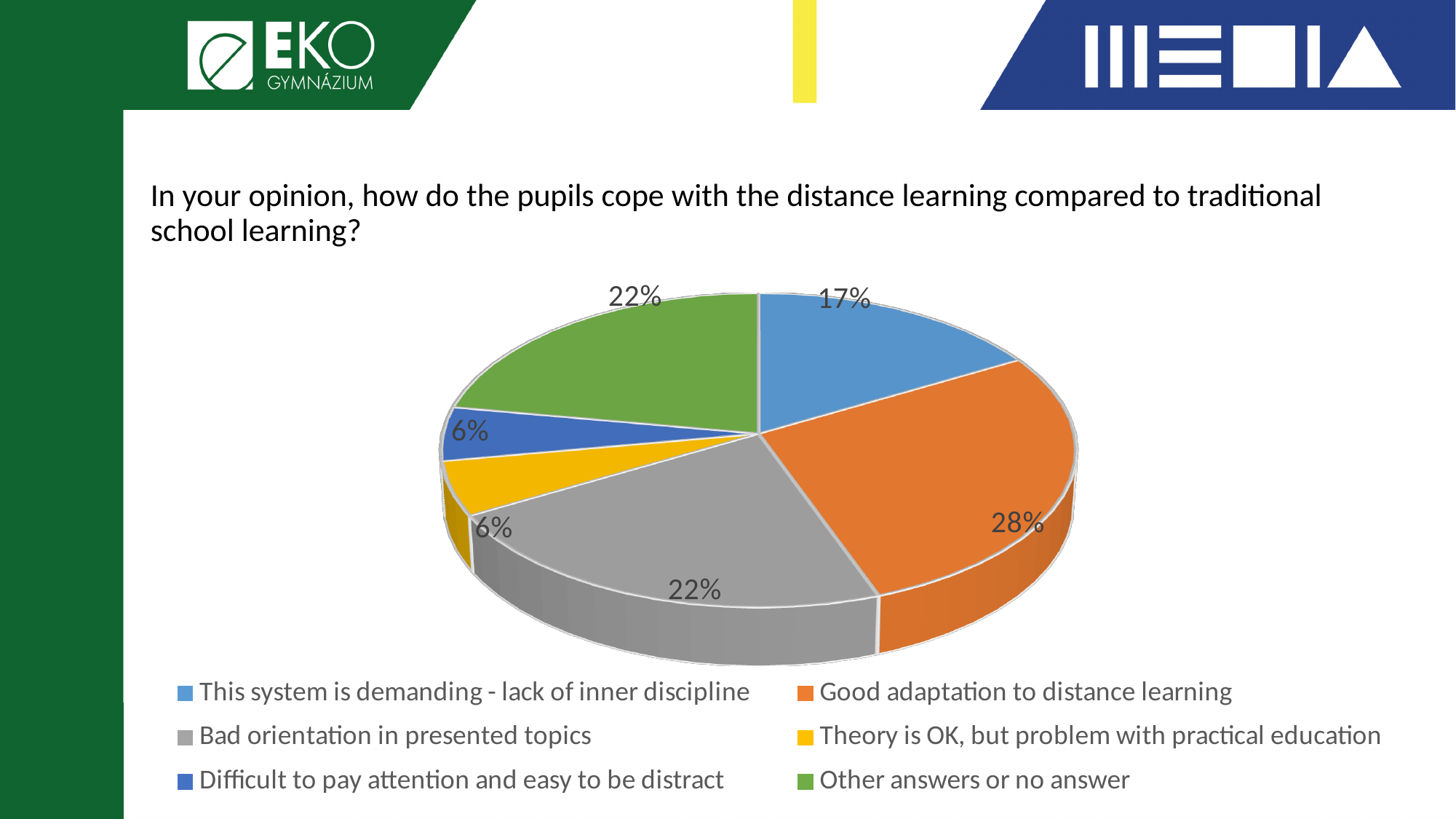
What share of the pie is 'Good adaptation to distance learning'? 28% What is the difference between the share for 'Good adaptation to distance learning' and the share for 'This system is demanding - lack of inner discipline'? 11% What share of the pie is 'Other answers or no answer'? 22% What share of the pie is 'Theory is OK, but problem with practical education'? 6% What colour is the slice for 'Other answers or no answer'? Green What share of the pie is 'Bad orientation in presented topics'? 22% Which is larger: the share for 'Bad orientation in presented topics' or the share for 'This system is demanding - lack of inner discipline'? Bad orientation in presented topics What kind of chart is shown on the slide? Pie chart How many categories does the legend list? 6 What share of the pie is 'This system is demanding - lack of inner discipline'? 17% Which category has the largest share of the pie? Good adaptation to distance learning What question is the chart answering, according to the slide title? In your opinion, how do the pupils cope with the distance learning compared to traditional school learning?